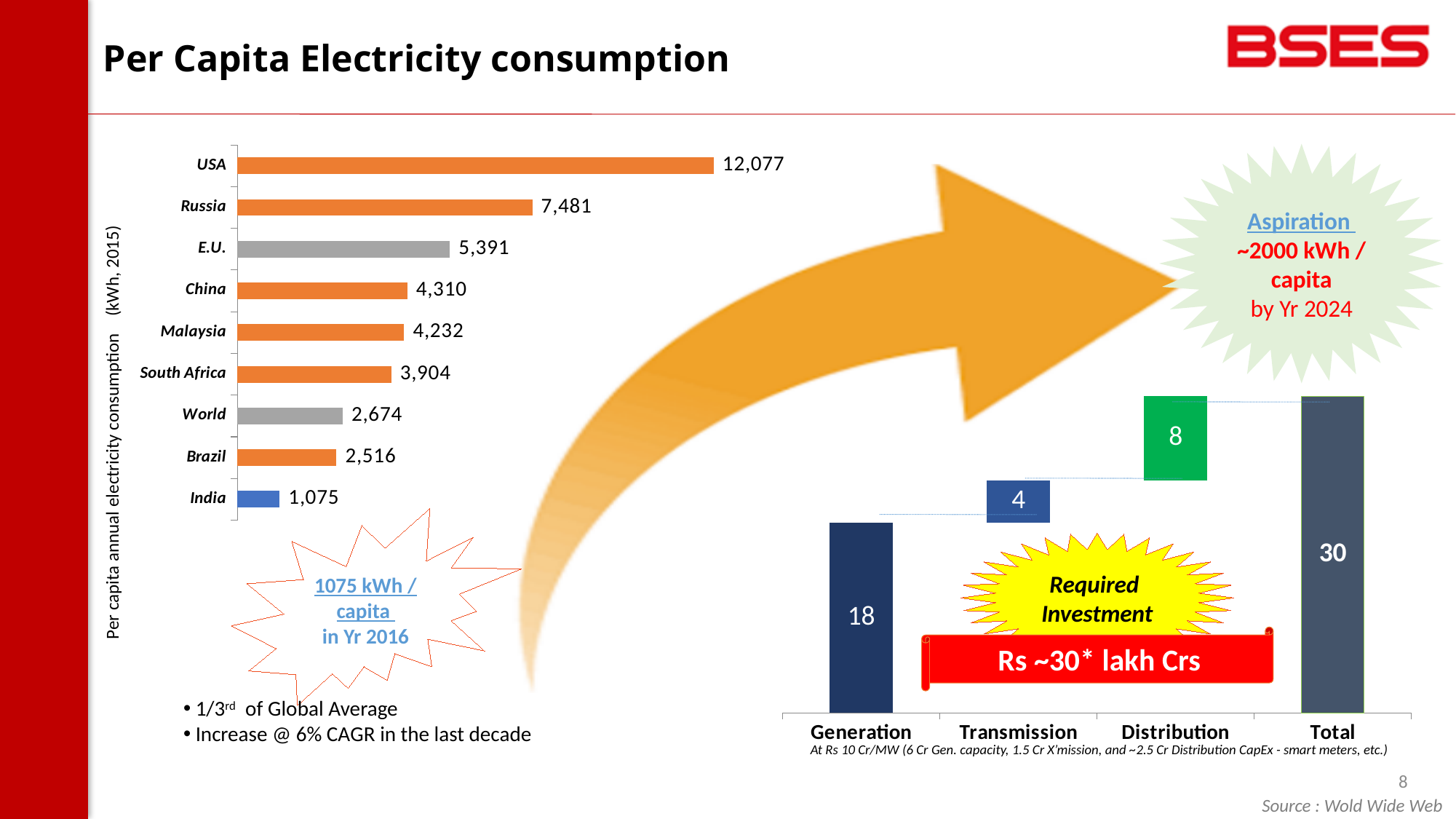
In the required investment chart on the right, what is the value for Generation? 18 In the required investment chart on the right, what is the difference between Generation and Transmission? 14 What type of chart is the per capita electricity consumption chart on the left? Bar chart In the per capita electricity consumption bar chart on the left, what is the value for the World? 2,674 In the per capita electricity consumption bar chart on the left, what is the value for the USA? 12,077 In the per capita electricity consumption bar chart on the left, which is larger, China or Malaysia? China How many countries or regions are listed in the per capita electricity consumption bar chart on the left? 9 In the per capita electricity consumption bar chart on the left, which country has the lowest consumption? India In the required investment chart on the right, what is the value for Distribution? 8 In the per capita electricity consumption bar chart on the left, which country has the highest consumption? USA In the per capita electricity consumption bar chart on the left, what is the value for India? 1,075 In the per capita electricity consumption bar chart on the left, what is the difference between Russia and the E.U.? 2,090